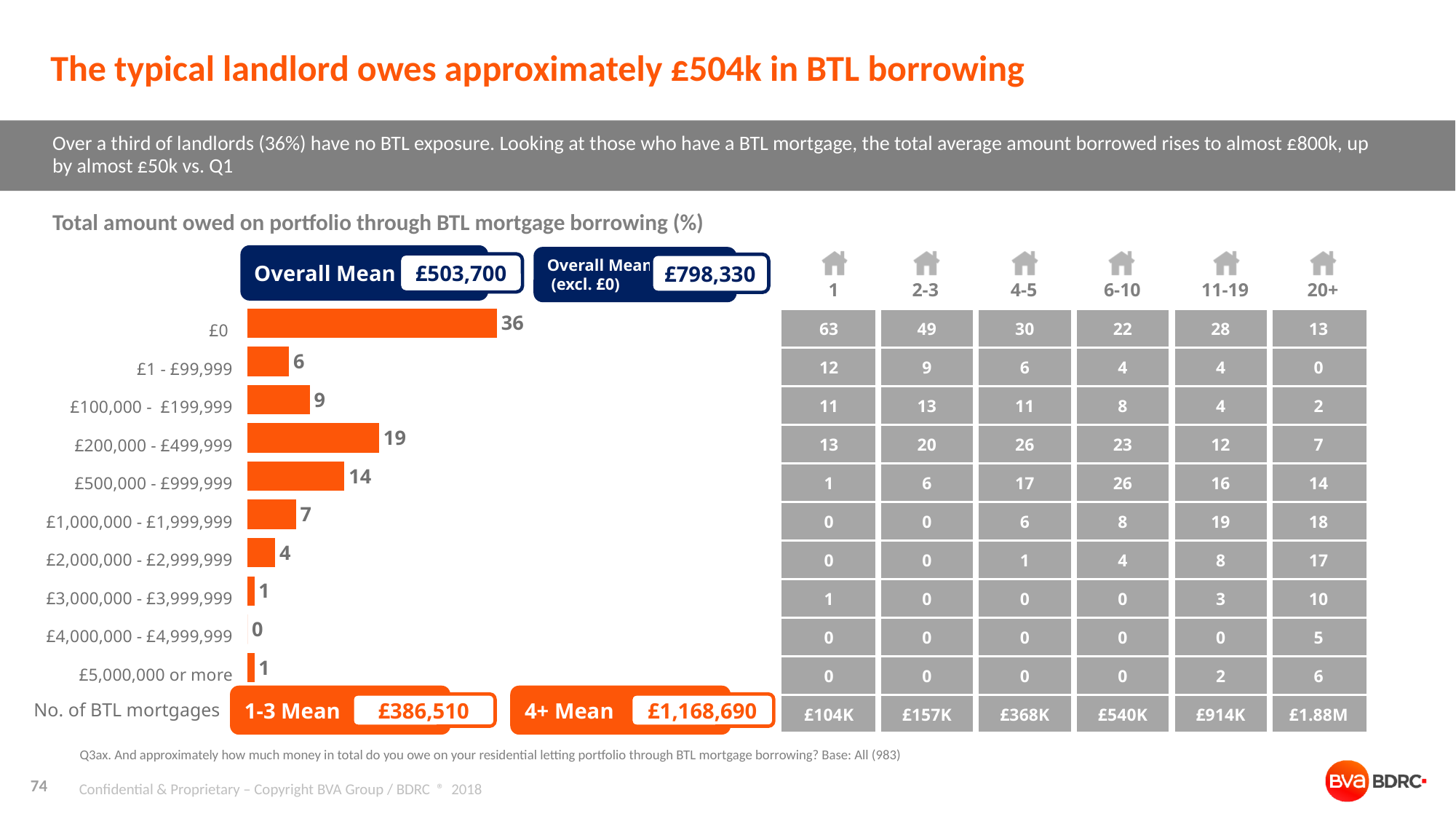
What is the value for the £2,000,000 - £2,999,999 category in the bar chart? 4 What is the Overall Mean shown above the bar chart? £503,700 How many categories are shown in the bar chart? 10 What is the 4+ Mean shown below the bar chart? £1,168,690 What is the value for the £0 category in the bar chart? 36 What kind of chart is shown on the slide? Bar chart What is the difference between the values for £200,000 - £499,999 and £500,000 - £999,999? 5 What is the value for the £200,000 - £499,999 category in the bar chart? 19 Which category has the highest value in the bar chart? £0 What is the value for the £500,000 - £999,999 category in the bar chart? 14 Which is larger in the bar chart: the value for £1 - £99,999 or the value for £100,000 - £199,999? £100,000 - £199,999 Which category has the lowest value in the bar chart? £4,000,000 - £4,999,999